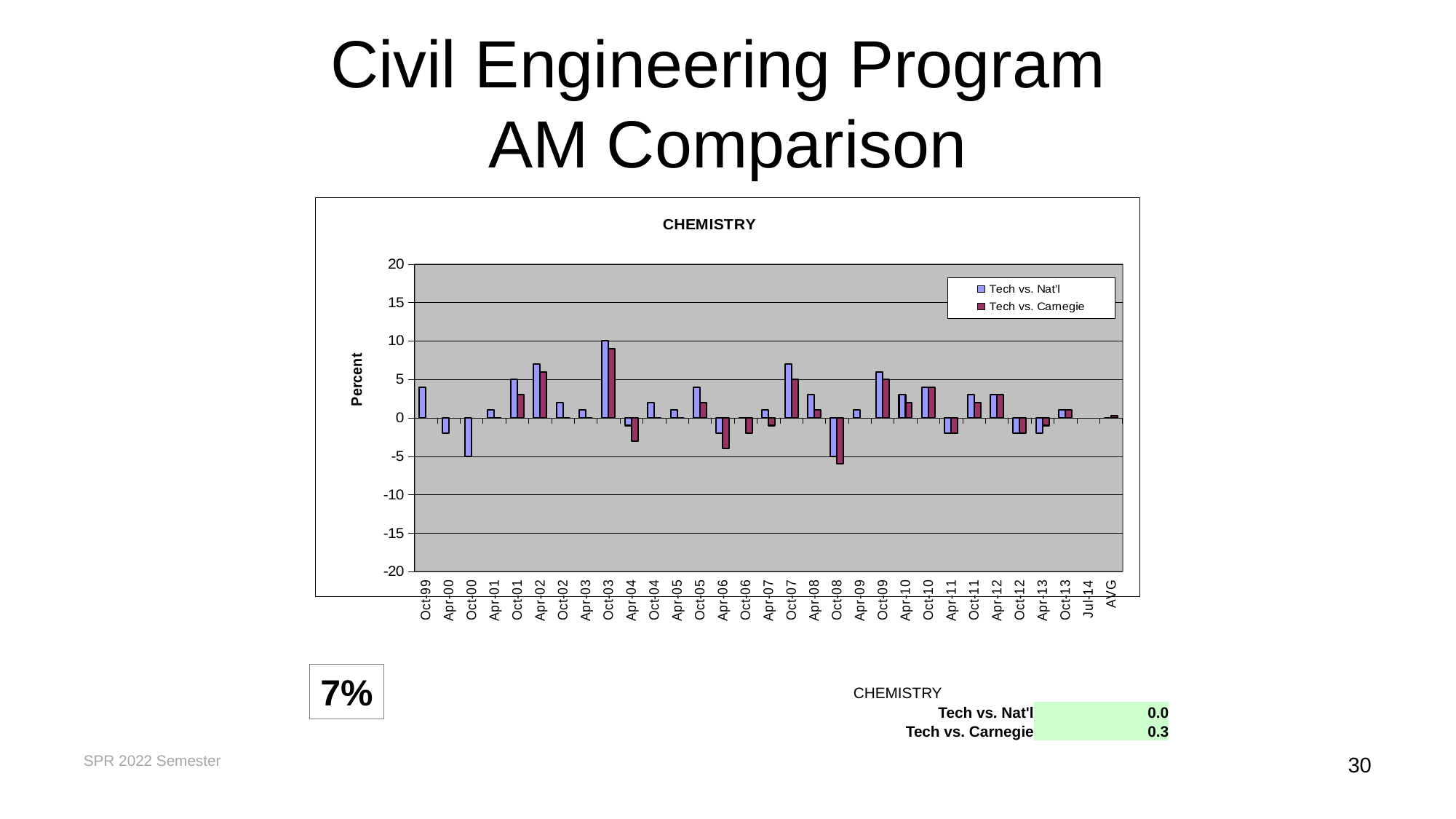
In which period does the Tech vs. Carnegie series reach its lowest value? Oct-08 How many categories are shown along the x axis of the chart? 31 How many series does the chart's legend list? 2 What are the two series named in the legend? Tech vs. Nat'l and Tech vs. Carnegie Is the Tech vs. Carnegie value for Apr-06 greater or less than 0? less Is the Tech vs. Nat'l value for Oct-03 greater or less than 5? greater What kind of chart is shown on the slide? bar chart According to the table below the chart, what is the Tech vs. Carnegie value for CHEMISTRY? 0.3 In which period does the Tech vs. Nat'l series reach its highest value? Oct-03 Is the Tech vs. Nat'l value for Oct-00 greater or less than 0? less For Oct-01, which series has the larger value, Tech vs. Nat'l or Tech vs. Carnegie? Tech vs. Nat'l What is the title of the chart? CHEMISTRY